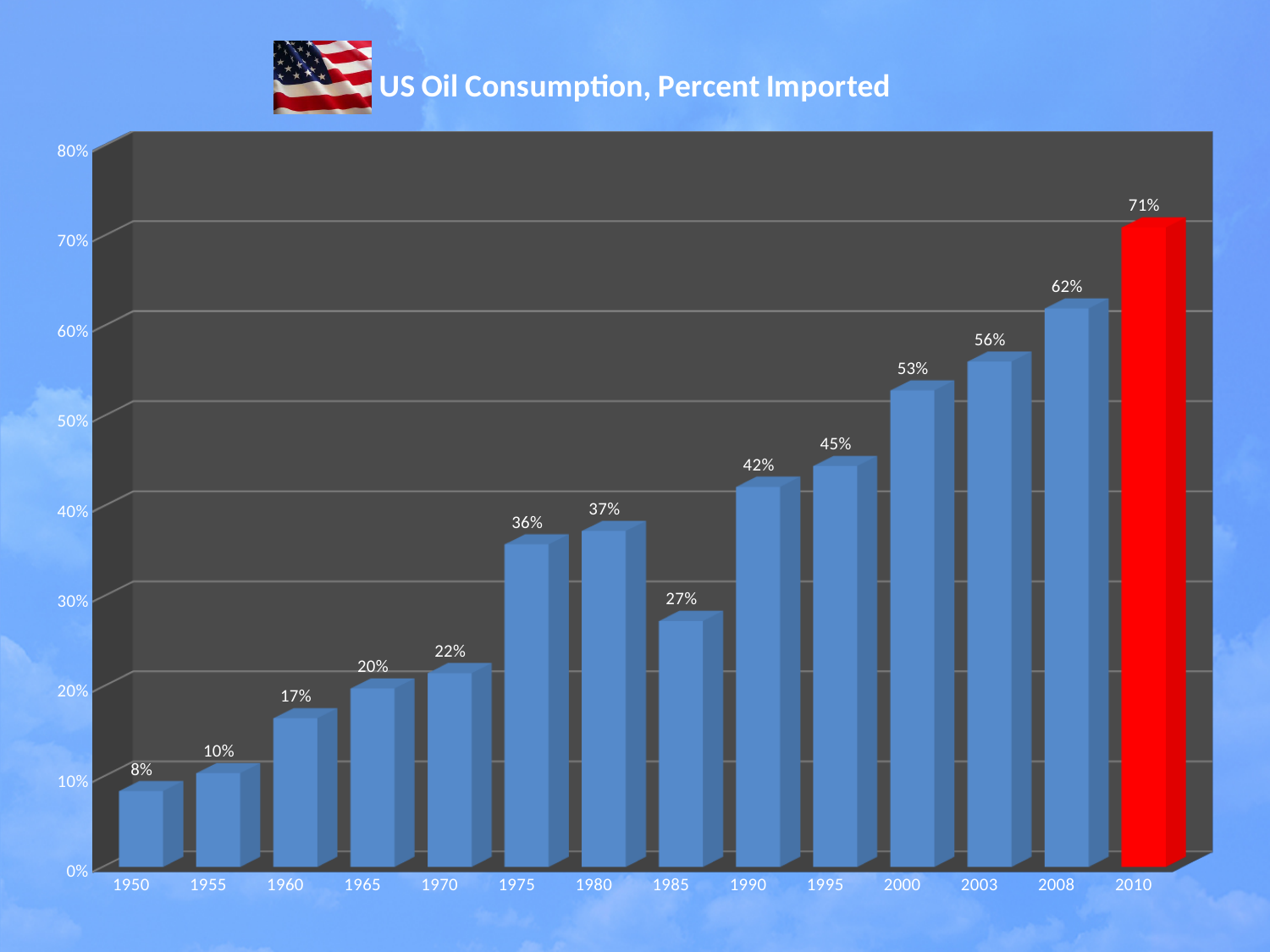
Which year has the lowest percent imported? 1950 How many years are shown on the x axis? 14 What kind of chart is shown on the slide? Bar chart What percent of US oil consumption was imported in 1950? 8% Which is larger, the value for 1980 or the value for 1985? 1980 Which year has the highest percent imported? 2010 Which bar is coloured red instead of blue? 2010 What is the value shown for 2010? 71% What percent of US oil consumption was imported in 1985? 27% What is the difference between the values for 2008 and 2000? 9% Do the values generally rise or fall from 1950 to 2010? Rise What is the title of the chart? US Oil Consumption, Percent Imported